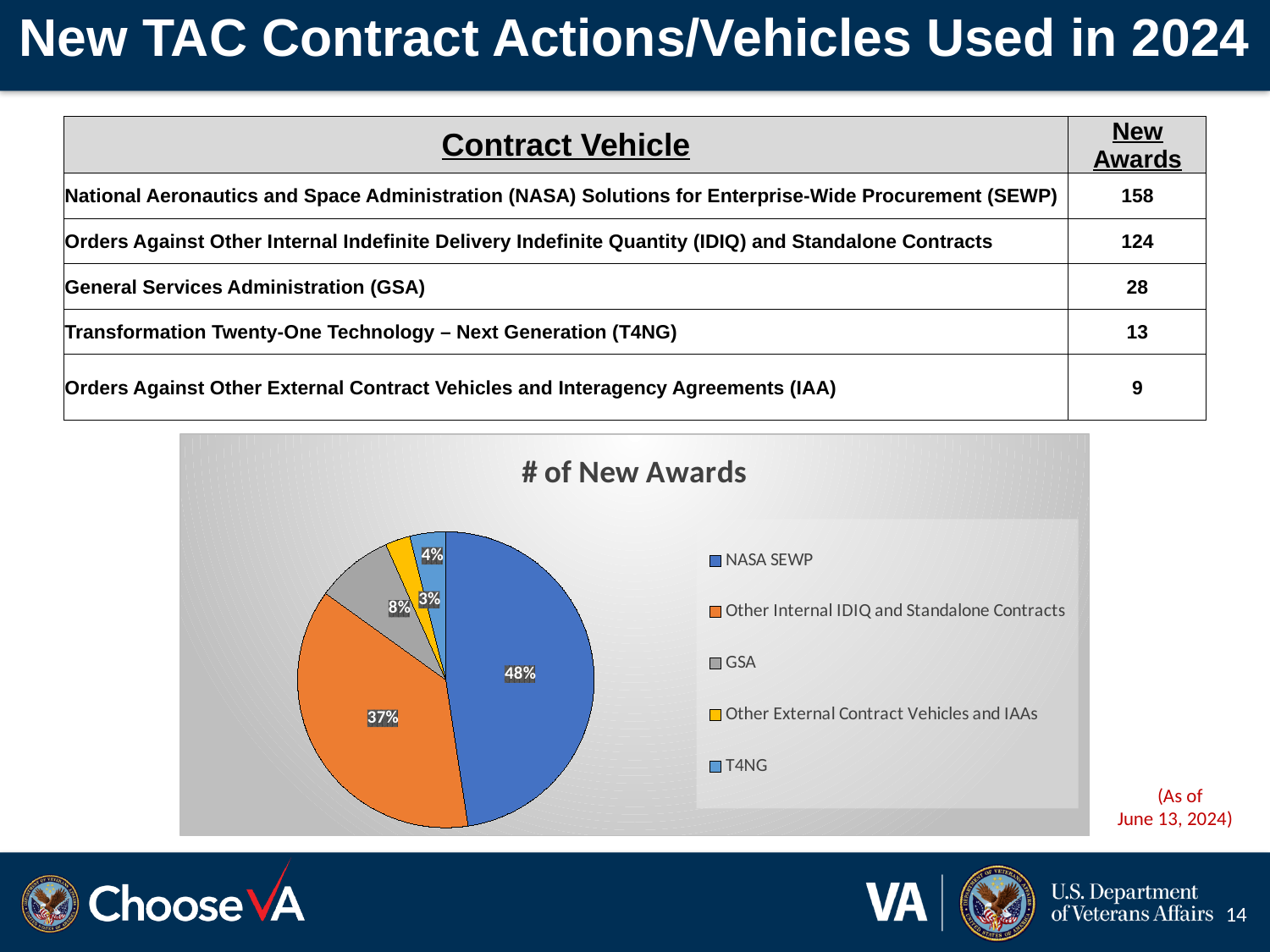
Which category has the smallest slice of the pie? Other External Contract Vehicles and IAAs What share of the pie does GSA represent? 8% How many entries does the chart's legend list? 5 What share of the pie does T4NG represent? 4% Which slice is larger, GSA or T4NG? GSA Which category has the largest slice of the pie? NASA SEWP What is the title of the chart? # of New Awards What share of the pie does Other Internal IDIQ and Standalone Contracts represent? 37% What is the difference in percentage points between the NASA SEWP slice and the Other Internal IDIQ and Standalone Contracts slice? 11 What kind of chart is shown on the slide? pie chart